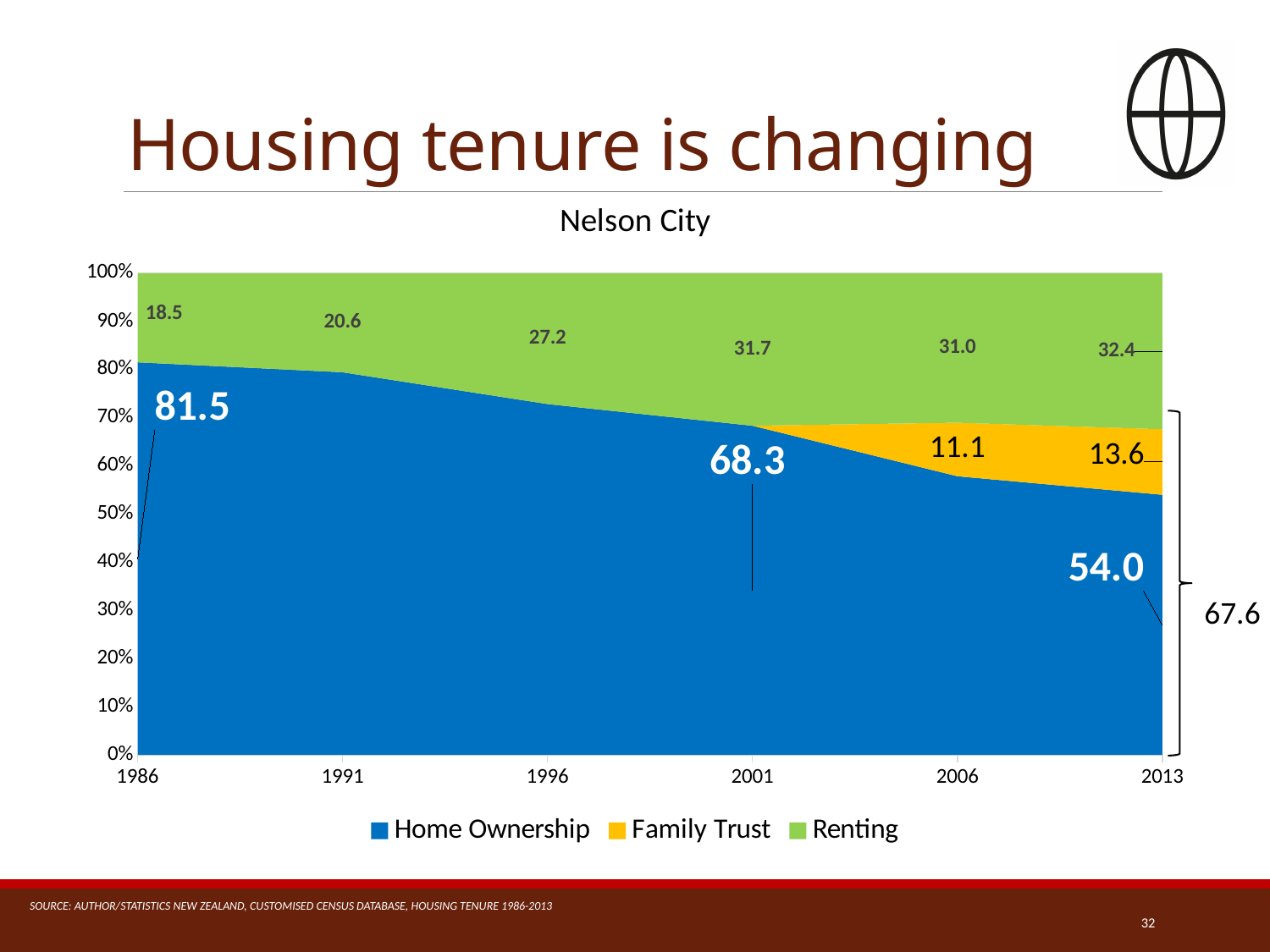
What is the Renting value for 2001? 31.7 What kind of chart is shown on the slide? Stacked area chart What is the Renting value for 1986? 18.5 How many series does the legend list? 3 In which year is the labelled Renting value highest? 2013 What is the Home Ownership value for 2001? 68.3 What is the Family Trust value for 2006? 11.1 How many years are shown on the x axis? 6 Which is larger, the Renting value for 1996 or for 1991? 1996 What is the Home Ownership value for 2013? 54.0 What is the difference between the Home Ownership value in 1986 and in 2013? 27.5 In which year is the labelled Renting value lowest? 1986